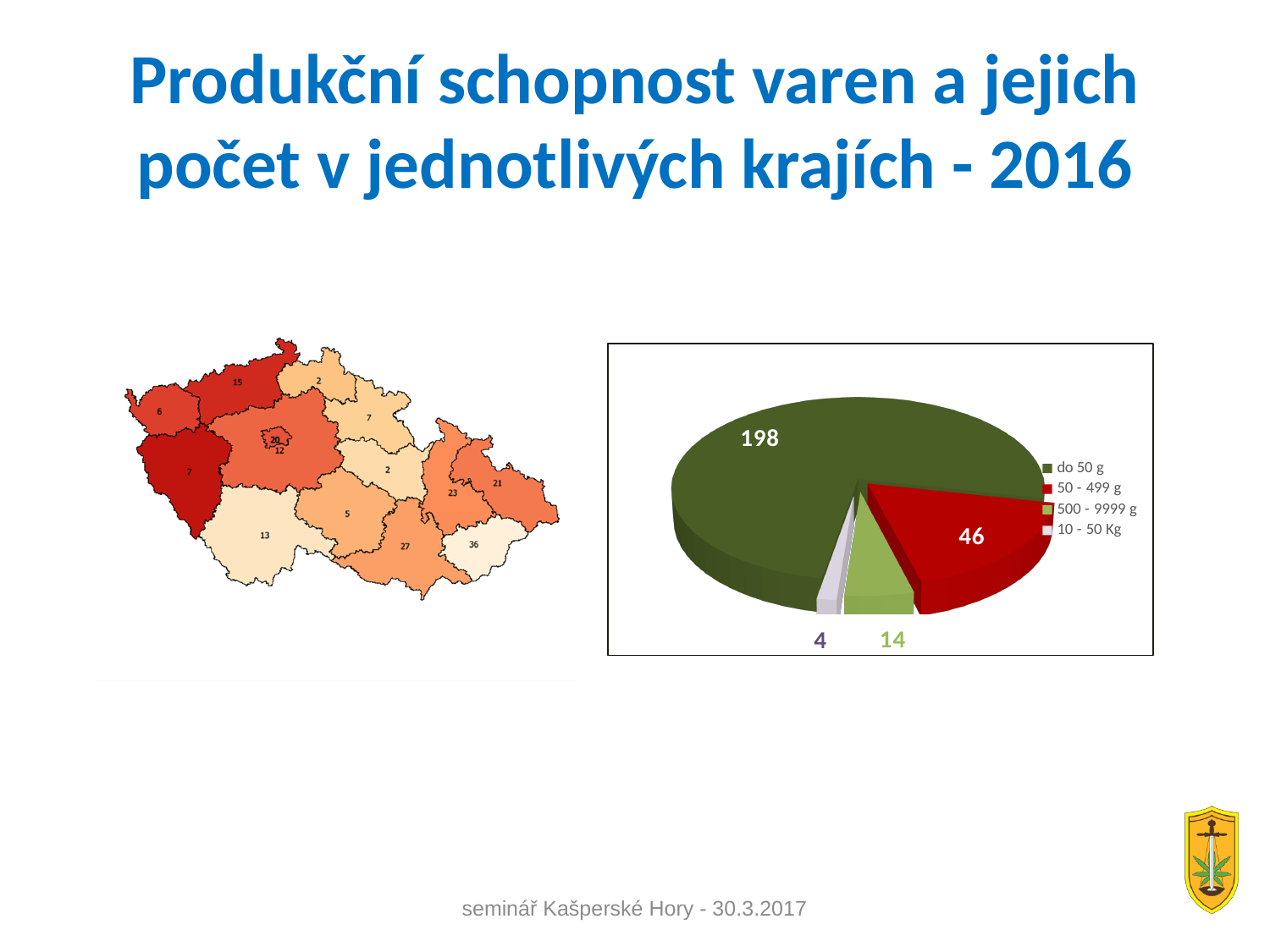
In the pie chart, what value is shown for the 'do 50 g' slice? 198 In the pie chart, which category has the largest slice? do 50 g In the pie chart, what value is shown for the '10 - 50 Kg' slice? 4 What kind of chart is shown on the right side of the slide? pie chart What is the total of all the values shown in the pie chart? 262 How many slices does the pie chart have? 4 In the pie chart, what value is shown for the '500 - 9999 g' slice? 14 In the pie chart, what value is shown for the '50 - 499 g' slice? 46 In the pie chart, what is the difference between the 'do 50 g' value and the '50 - 499 g' value? 152 In the pie chart, which is larger: the '50 - 499 g' slice or the '500 - 9999 g' slice? 50 - 499 g In the pie chart, which category has the smallest slice? 10 - 50 Kg What colour is the 'do 50 g' slice in the pie chart? dark green